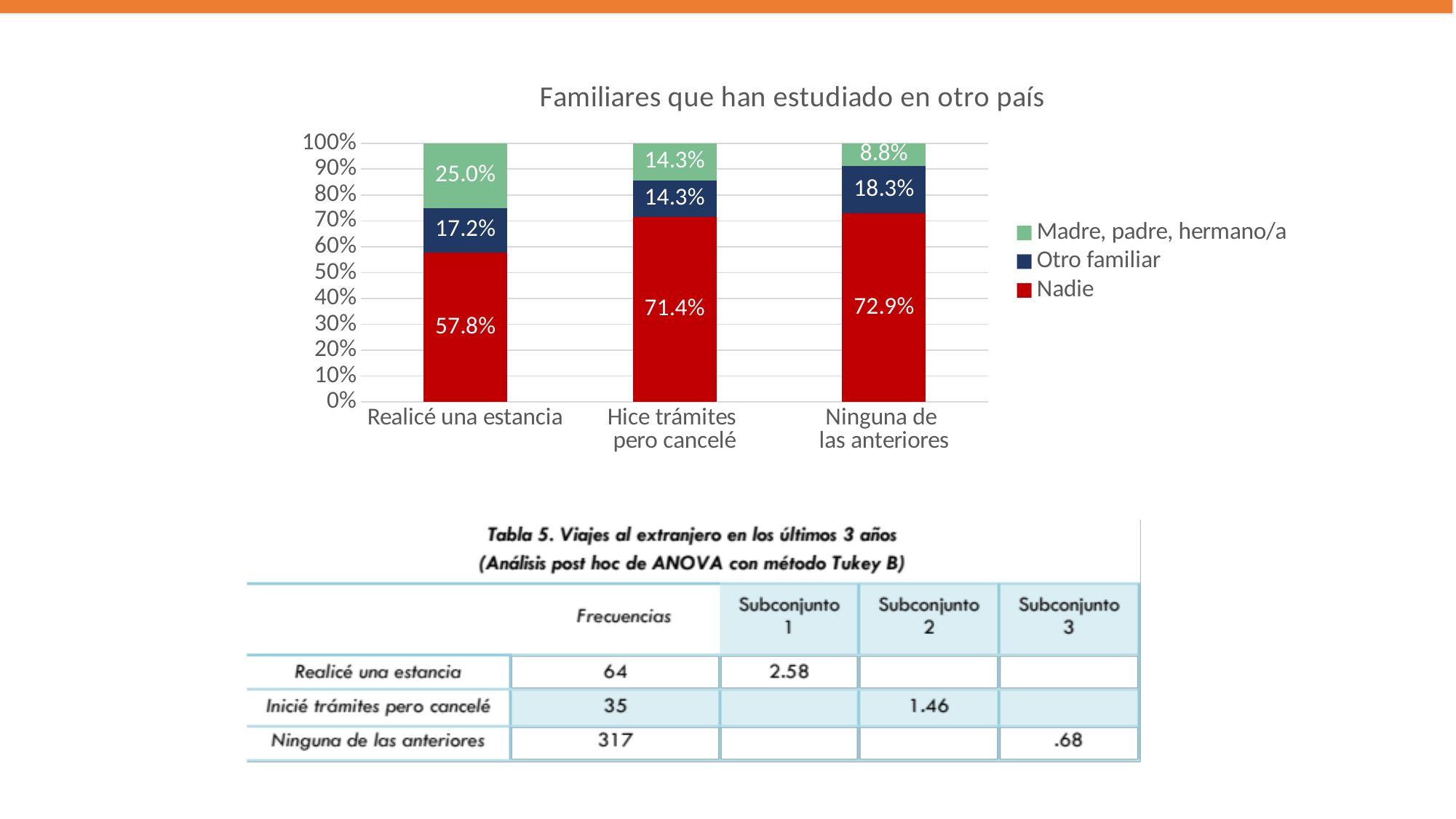
What is the value for Otro familiar in the Hice trámites pero cancelé category? 14.3% How many categories are shown on the x axis of the chart? 3 What is the value for Madre, padre, hermano/a in the Ninguna de las anteriores category? 8.8% What is the difference between the Nadie values for Ninguna de las anteriores and Realicé una estancia? 15.1% How many series does the chart legend list? 3 What is the value for Nadie in the Realicé una estancia category? 57.8% Which category has the lowest value for Madre, padre, hermano/a? Ninguna de las anteriores Which category has the highest value for Nadie? Ninguna de las anteriores What kind of chart is shown on the slide? Stacked bar chart Is the Nadie value for Hice trámites pero cancelé greater or less than 60%? greater What is the title of the chart? Familiares que han estudiado en otro país Which is larger: the Otro familiar value for Ninguna de las anteriores or for Realicé una estancia? Ninguna de las anteriores